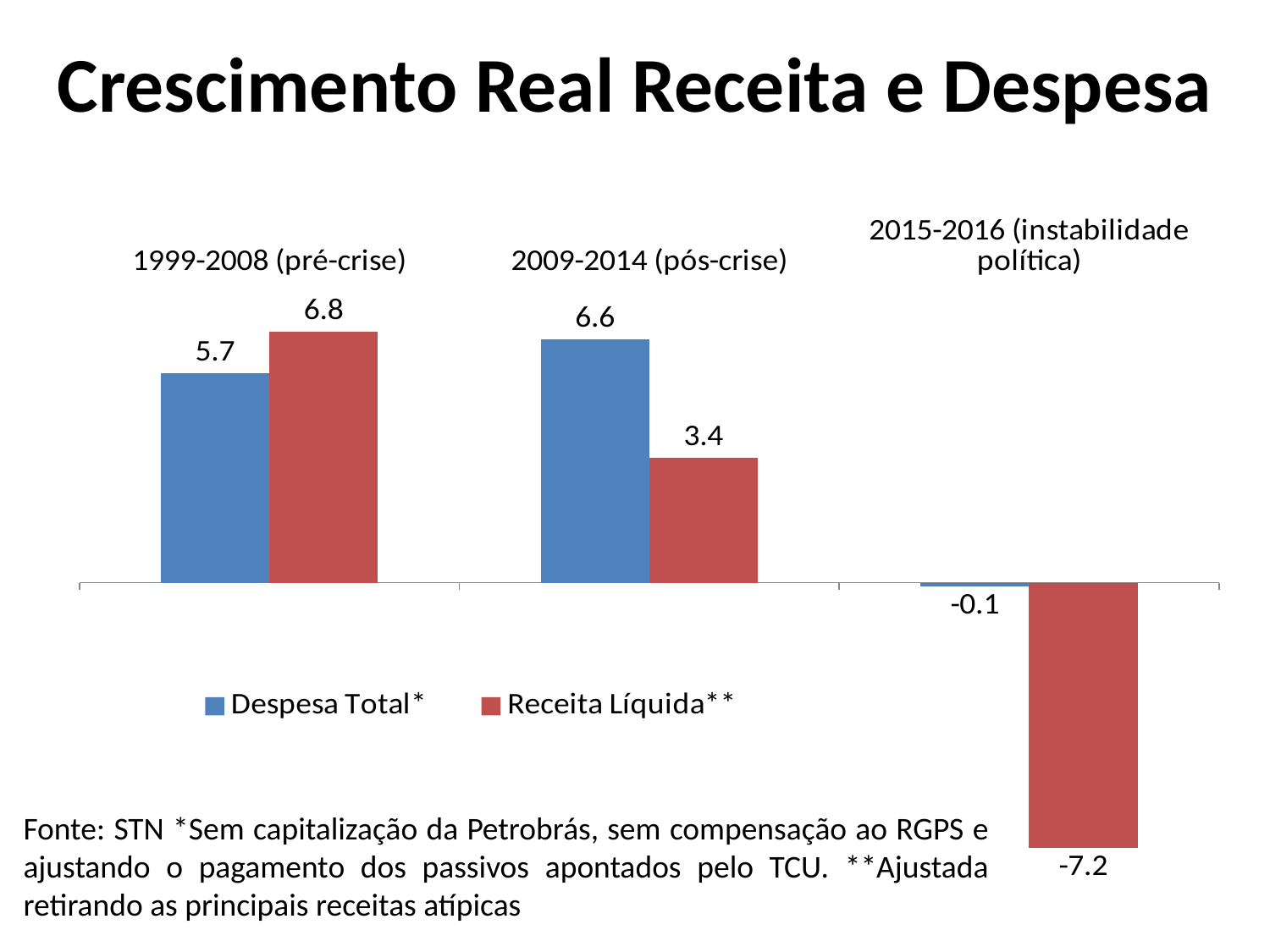
What kind of chart is shown on the slide? Bar chart What is the difference between Receita Líquida** and Despesa Total* for 1999-2008 (pré-crise)? 1.1 Which period has the highest Receita Líquida** value? 1999-2008 (pré-crise) How many series does the legend list? 2 How many periods are shown on the x axis? 3 For 2009-2014 (pós-crise), which is larger: Despesa Total* or Receita Líquida**? Despesa Total* What is the value of Despesa Total* for 1999-2008 (pré-crise)? 5.7 What is the difference between Despesa Total* and Receita Líquida** for 2009-2014 (pós-crise)? 3.2 What is the value of Receita Líquida** for 2015-2016 (instabilidade política)? -7.2 Which period has the lowest Despesa Total* value? 2015-2016 (instabilidade política) What is the value of Despesa Total* for 2015-2016 (instabilidade política)? -0.1 What is the value of Receita Líquida** for 2009-2014 (pós-crise)? 3.4